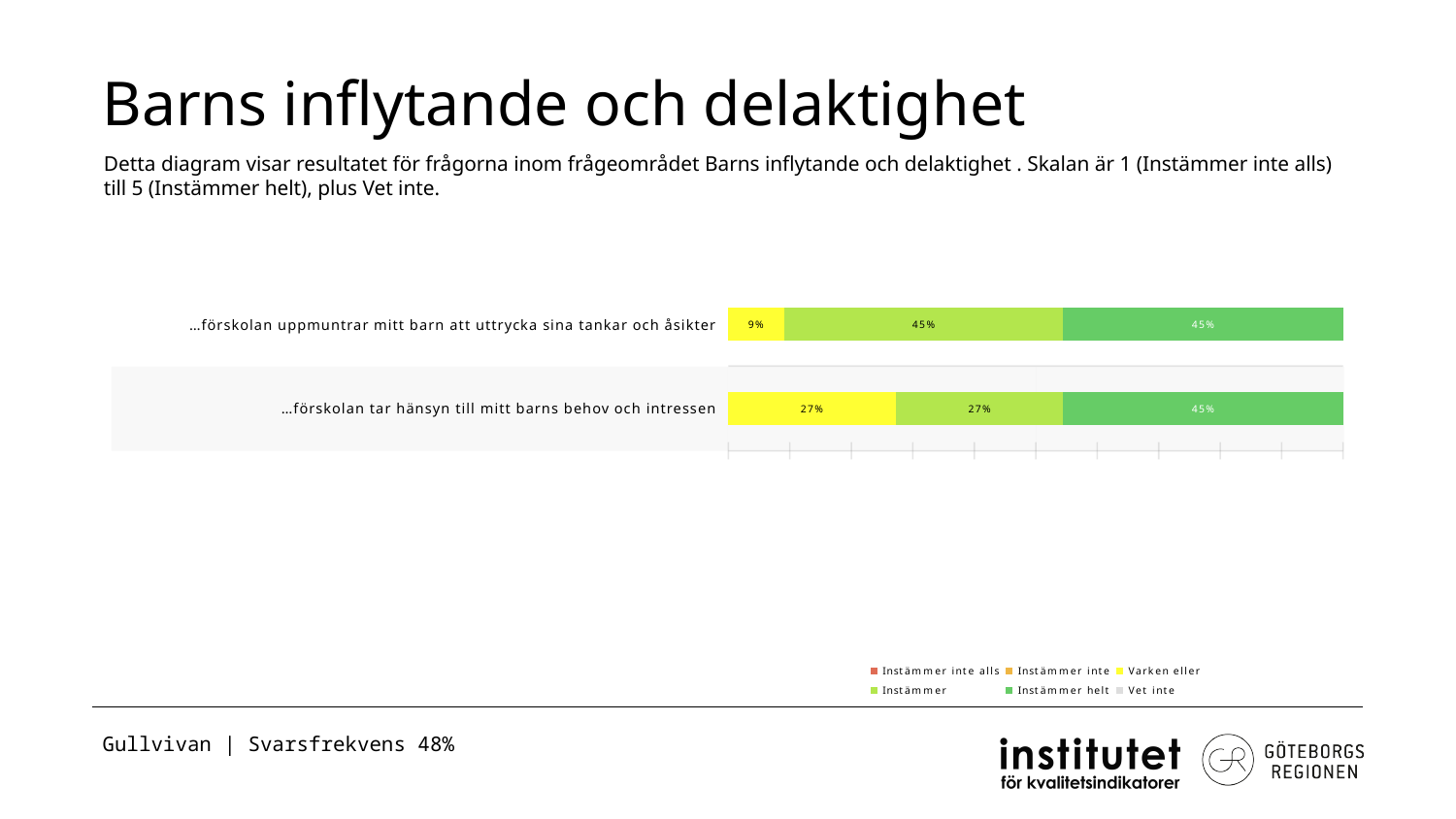
What is the 'Instämmer' value for '…förskolan tar hänsyn till mitt barns behov och intressen'? 27% What is the 'Instämmer' value for '…förskolan uppmuntrar mitt barn att uttrycka sina tankar och åsikter'? 45% What is the 'Varken eller' value for '…förskolan uppmuntrar mitt barn att uttrycka sina tankar och åsikter'? 9% What kind of chart is shown on the slide? Stacked bar chart How many categories (questions) are plotted in the chart? 2 What is the difference between the 'Varken eller' values of the two categories? 18% What is the total of the labelled segments in the bar for '…förskolan tar hänsyn till mitt barns behov och intressen'? 99% Is the 'Instämmer' value larger for '…förskolan uppmuntrar mitt barn att uttrycka sina tankar och åsikter' or for '…förskolan tar hänsyn till mitt barns behov och intressen'? …förskolan uppmuntrar mitt barn att uttrycka sina tankar och åsikter What is the title of the slide containing the chart? Barns inflytande och delaktighet How many series does the legend list? 6 Which category has the higher 'Varken eller' value? …förskolan tar hänsyn till mitt barns behov och intressen What is the 'Instämmer helt' value for '…förskolan tar hänsyn till mitt barns behov och intressen'? 45%